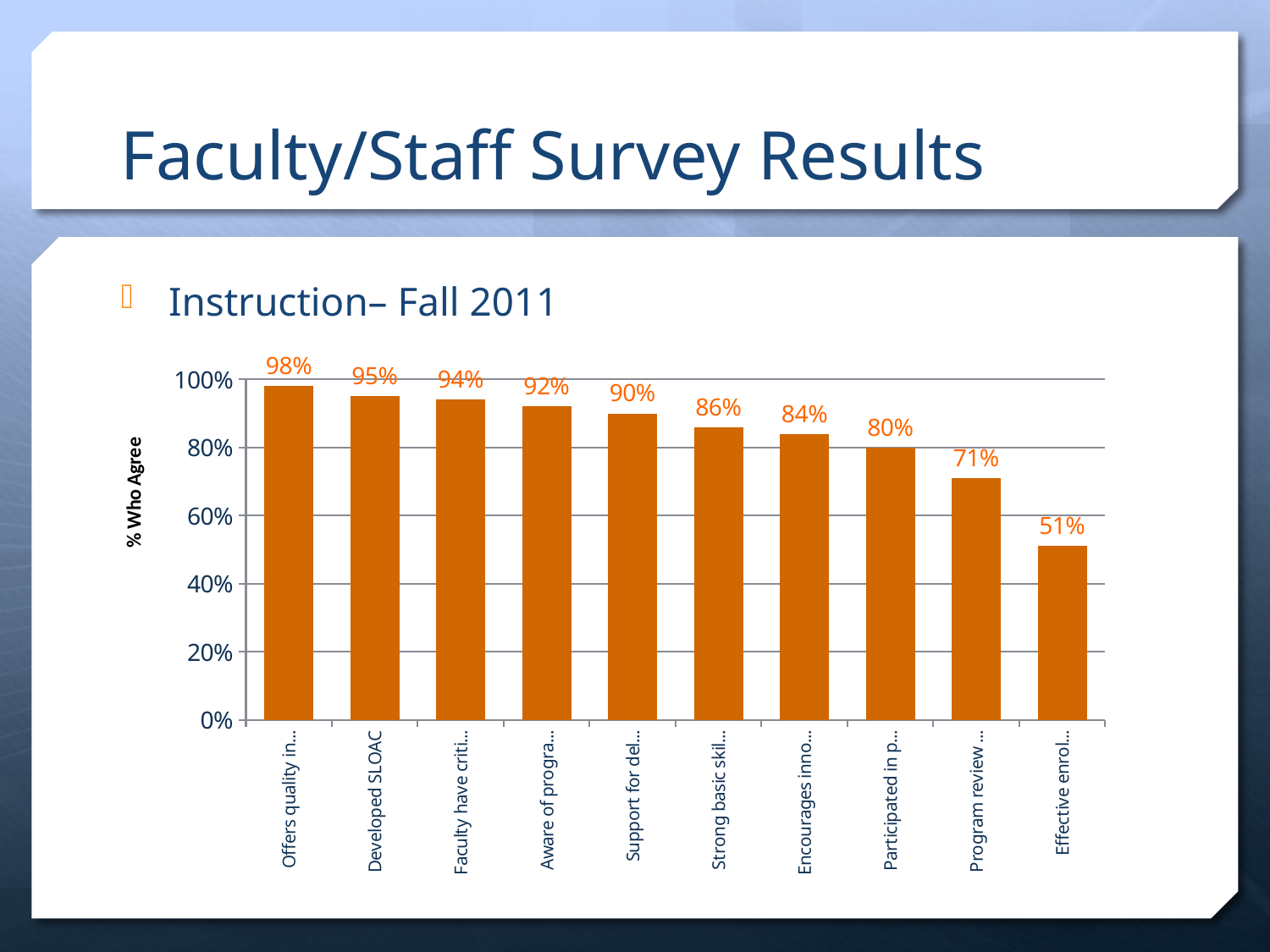
What type of chart is shown on the slide? Bar chart What is the value of the rightmost bar (Effective enrol...)? 51% What is the difference between the highest value (98%) and the lowest value (51%)? 47 percentage points What is the value of the leftmost bar (Offers quality in...)? 98% What is the label of the vertical axis? % Who Agree What is the value of the bar labeled 'Program review ...'? 71% Which is larger, the value for 'Strong basic skil...' or the value for 'Encourages inno...'? Strong basic skil... (86%) What is the difference between Developed SLOAC and the bar labeled 'Participated in p...'? 15 percentage points Which bar has the highest value? Offers quality in... (the leftmost bar), 98% How many bars are shown in the chart? 10 Which bar has the lowest value? Effective enrol... (the rightmost bar), 51% What is the value for Developed SLOAC? 95%